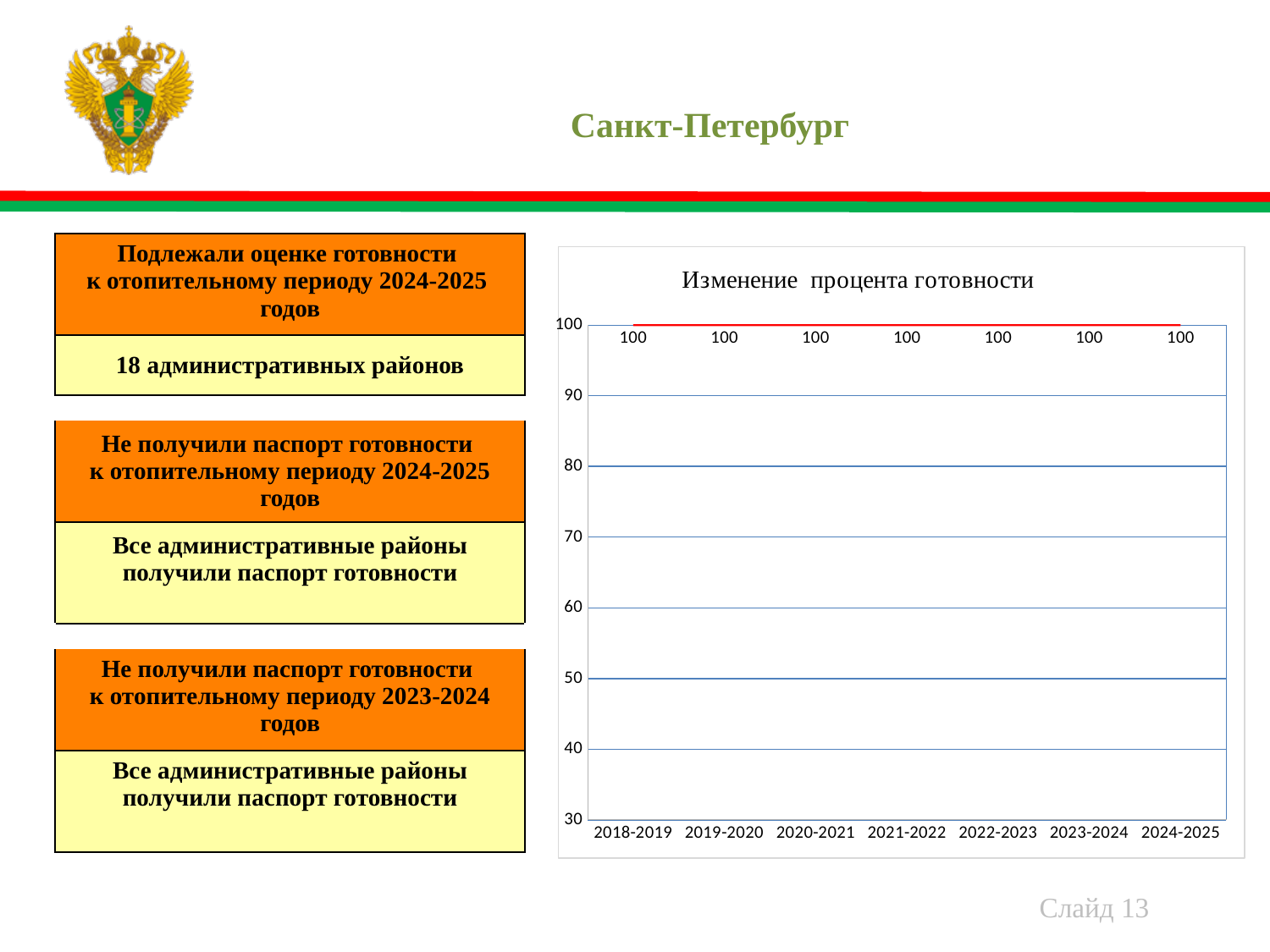
Is the value for 2022-2023 greater or less than 90? greater What is the lowest value shown on the y axis of the chart? 30 What kind of chart is shown on the slide? line chart What is the value for 2018-2019 in the chart? 100 Do the values rise, fall or stay the same from 2018-2019 to 2024-2025? stay the same How many periods are plotted along the x axis of the chart? 7 Is the value for 2020-2021 larger than, smaller than, or equal to the value for 2024-2025? equal What is the value for 2021-2022 in the chart? 100 What colour is the plotted line in the chart? red What is the difference between the values for 2019-2020 and 2023-2024? 0 What is the title of the chart? Изменение процента готовности What is the value for 2024-2025 in the chart? 100